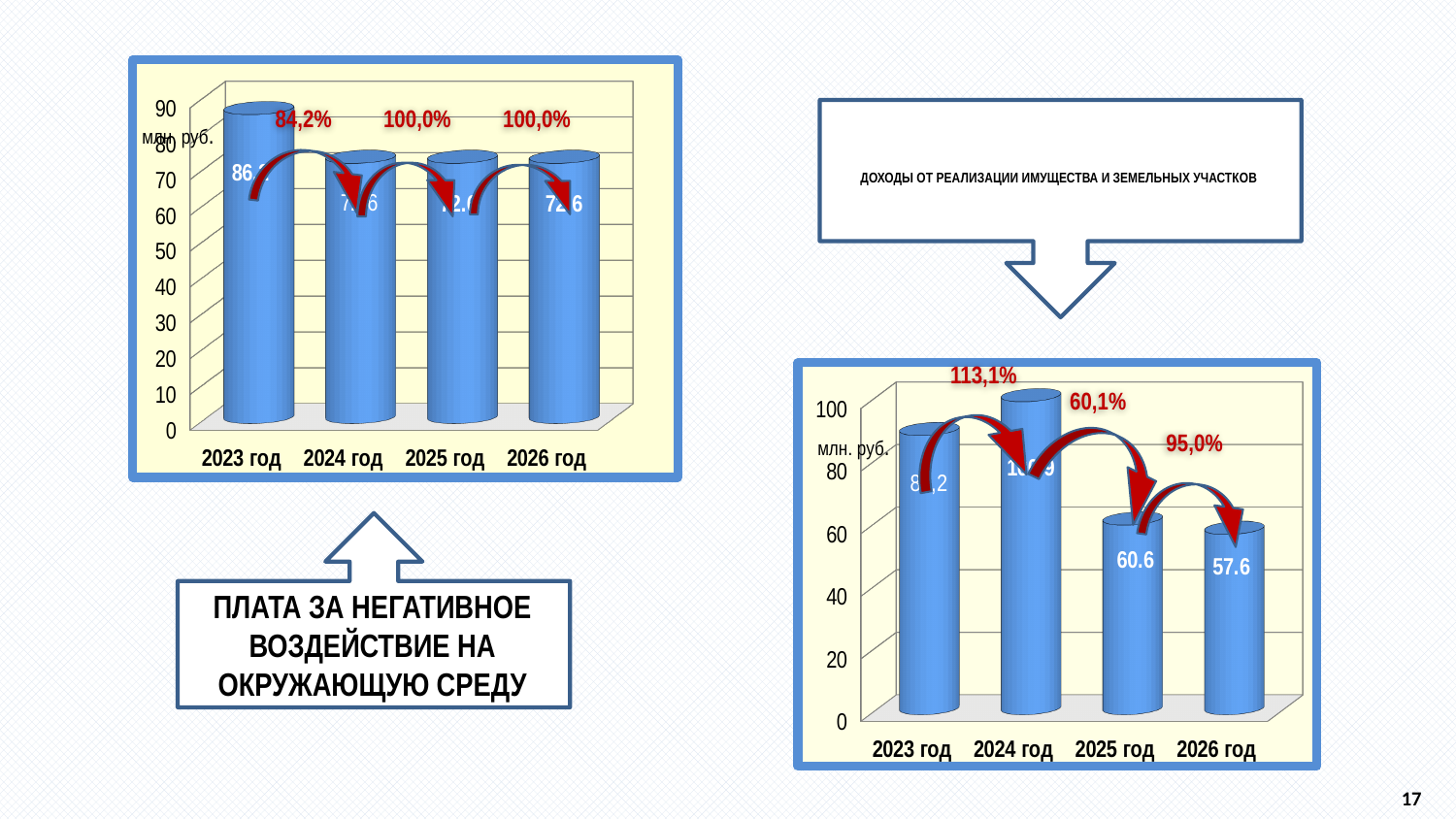
In the chart on the right (Доходы от реализации имущества и земельных участков), what is the value for 2026 год? 57.6 In the chart on the left, is the value for 2023 год greater or less than 80? greater In the chart on the right, which year has the highest value? 2024 год In the chart on the left, is the value for 2024 год greater or less than 80? less In the chart on the left, which year has the highest value? 2023 год In the chart on the left (Плата за негативное воздействие на окружающую среду), what is the value for 2026 год? 72.6 In the chart on the right, which is larger, the value for 2025 год or 2026 год? 2025 год In the chart on the right, which year has the lowest value? 2026 год How many years are shown on the x axis of the chart on the right? 4 What kind of chart is the chart on the left? bar chart In the chart on the right, what is the difference between the values for 2025 год and 2026 год? 3.0 In the chart on the right (Доходы от реализации имущества и земельных участков), what is the value for 2025 год? 60.6